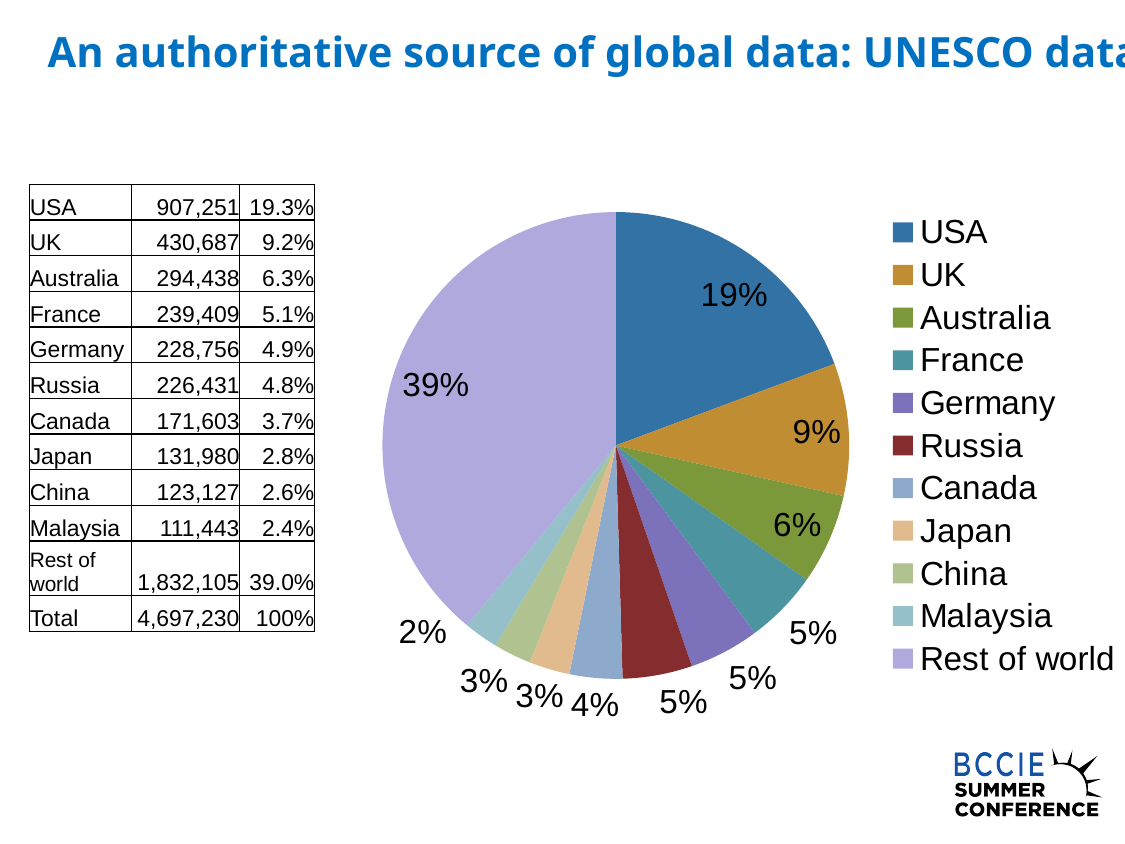
Which slice is larger in the pie chart, USA or UK? USA What percentage does the pie chart show for USA? 19% What kind of chart is shown on the slide? pie chart What percentage does the pie chart show for UK? 9% Which slice of the pie chart is the largest? Rest of world What percentage does the pie chart show for Rest of world? 39% Which slice is larger in the pie chart, Australia or Canada? Australia What percentage does the pie chart show for Malaysia? 2% How many slices does the pie chart have? 11 What colour is the Rest of world slice in the pie chart? light purple What is the difference in percentage points between the USA slice and the UK slice in the pie chart? 10 Which slice of the pie chart is the smallest? Malaysia